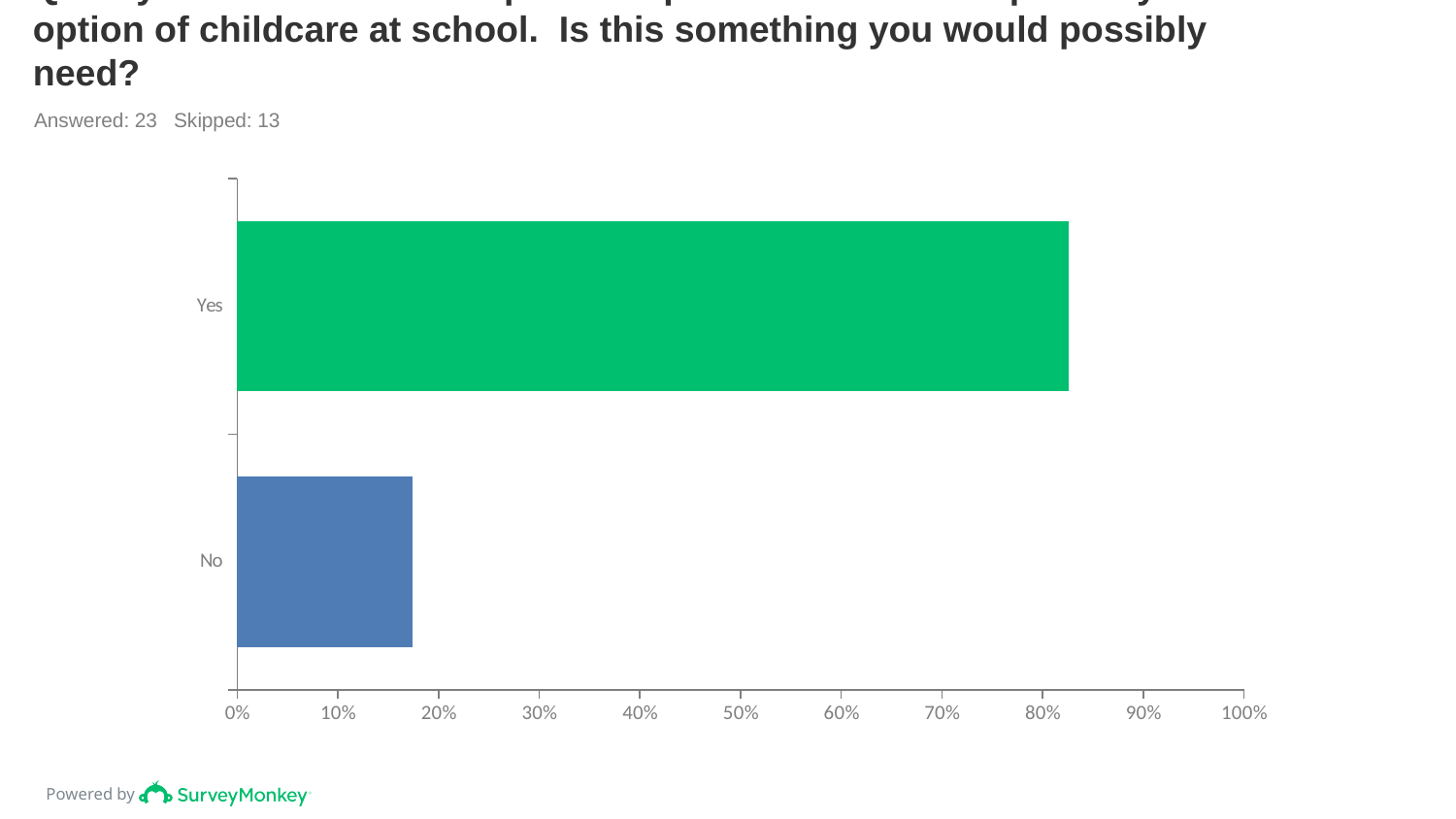
Which category has the lowest value in the chart? No Which category has the highest value in the chart? Yes Is the value for Yes greater or less than 70%? greater How many respondents answered the question according to the slide? 23 Is the value for No greater or less than 10%? greater What kind of chart is shown on the slide? bar chart Is the value for No greater or less than 20%? less What colour is the bar for Yes? green Which is larger, the value for Yes or the value for No? Yes How many categories are plotted in the chart? 2